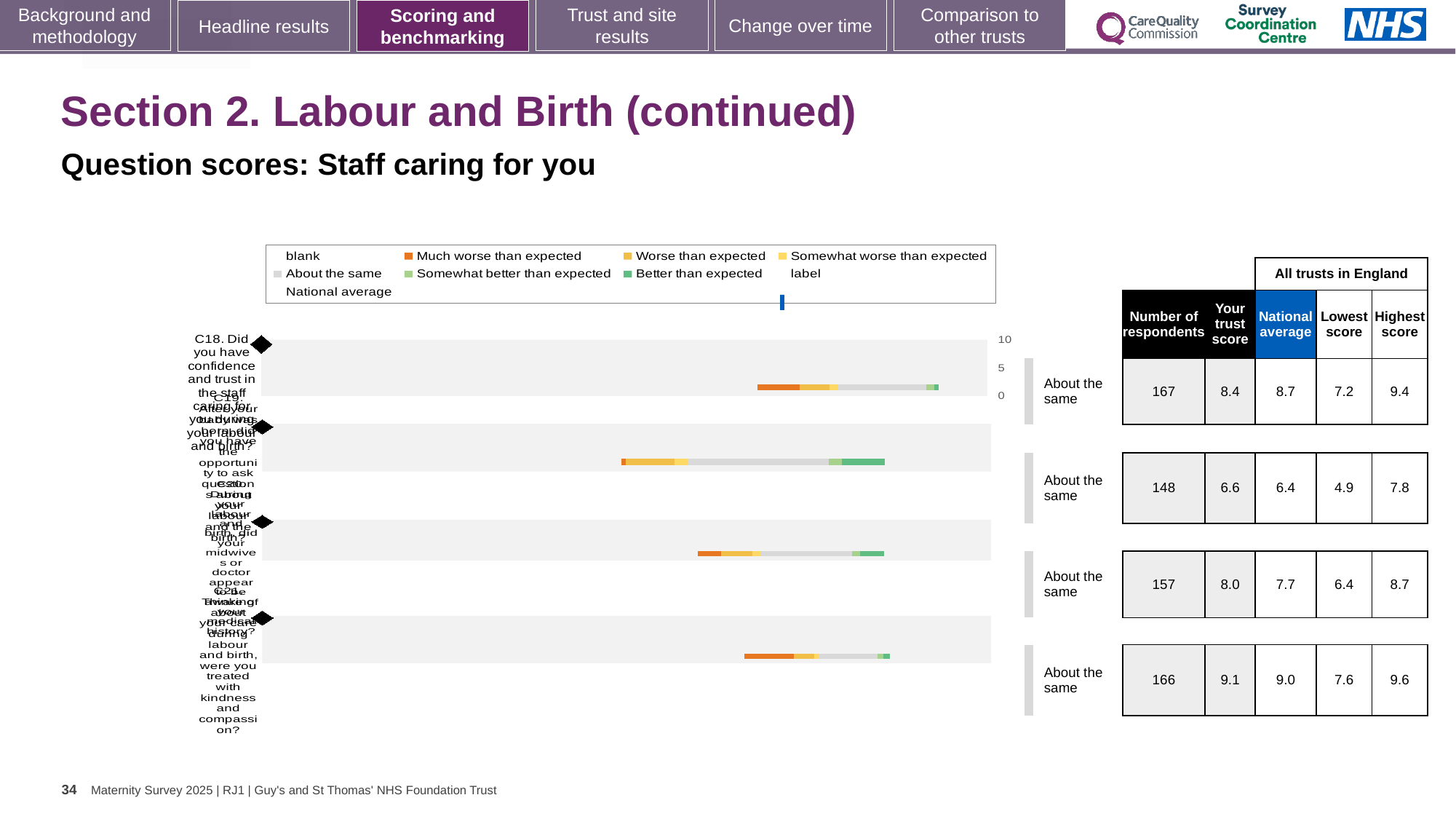
For the second row, which is larger: the trust score or the national average? the trust score (6.6) What colour represents 'Much worse than expected' in the legend? orange What benchmark category is shown for every row of the chart? About the same What kind of chart is used to show the question scores on this slide? bar chart What is the trust score for the first row (C18, confidence and trust in the staff caring for you)? 8.4 For the third row, how much higher is the trust score than the national average? 0.3 Which row of the chart has the lowest trust score? the second row (C19), 6.6 How many respondents are recorded for the second row of the chart? 148 How many questions (rows) are plotted in the chart? 4 Which row of the chart has the highest trust score? the bottom row (C21), 9.1 What is the national average for the first row (C18)? 8.7 For the first row (C18), what is the difference between the highest score and the lowest score across all trusts in England? 2.2